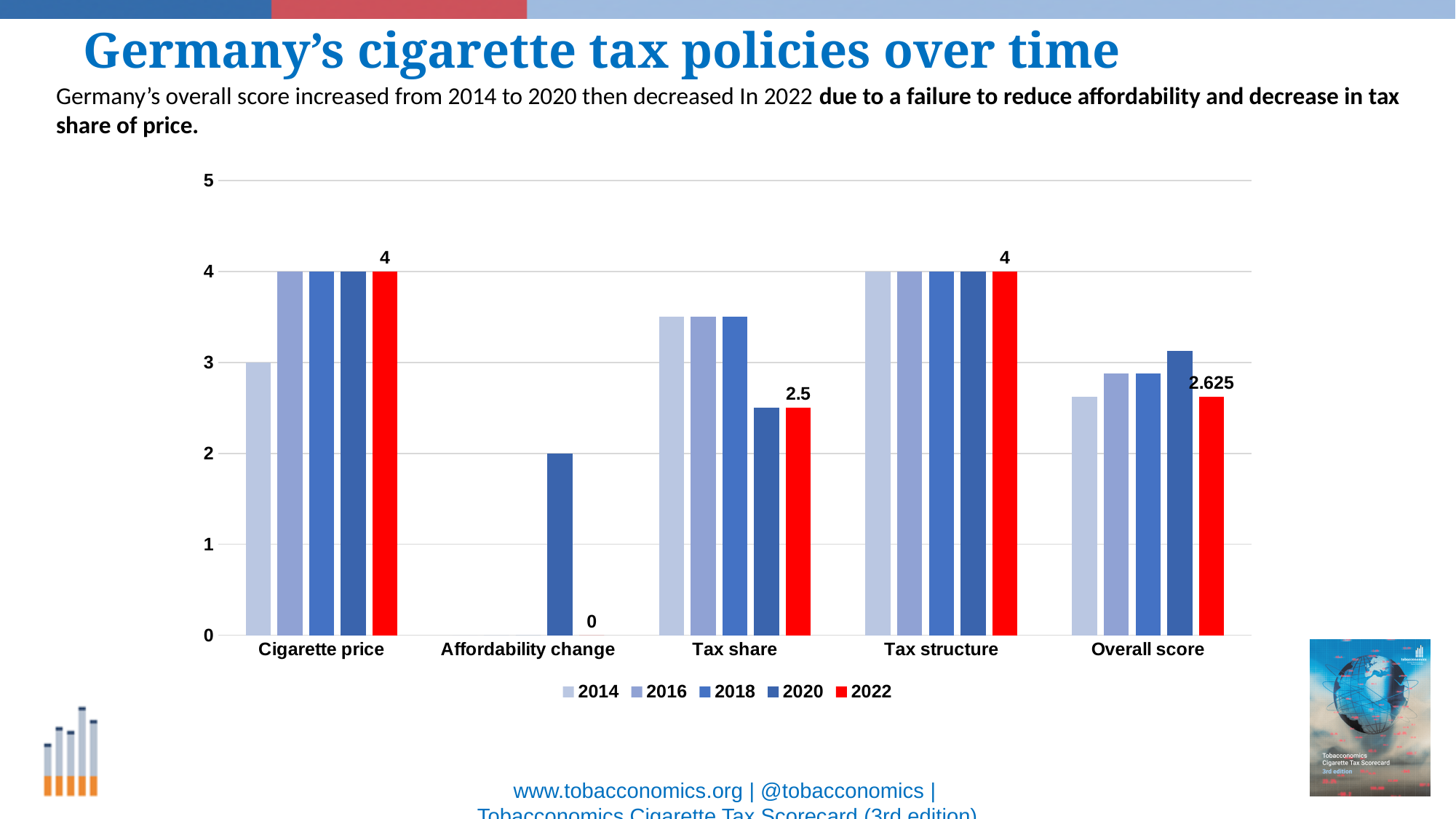
Is the 2020 value for Overall score greater or less than 3? greater What kind of chart is shown on the slide? bar chart What is the 2022 value for Overall score? 2.625 What is the 2014 value for Cigarette price? 3 How many series does the legend list? 5 What is the 2022 value for Tax share? 2.5 How many categories are shown on the x axis? 5 What is the difference between the 2022 values for Tax structure and Tax share? 1.5 Which is larger in 2022: Tax share or Tax structure? Tax structure What colour represents the 2022 series in the chart? red What is the 2022 value for Cigarette price? 4 What is the 2022 value for Affordability change? 0